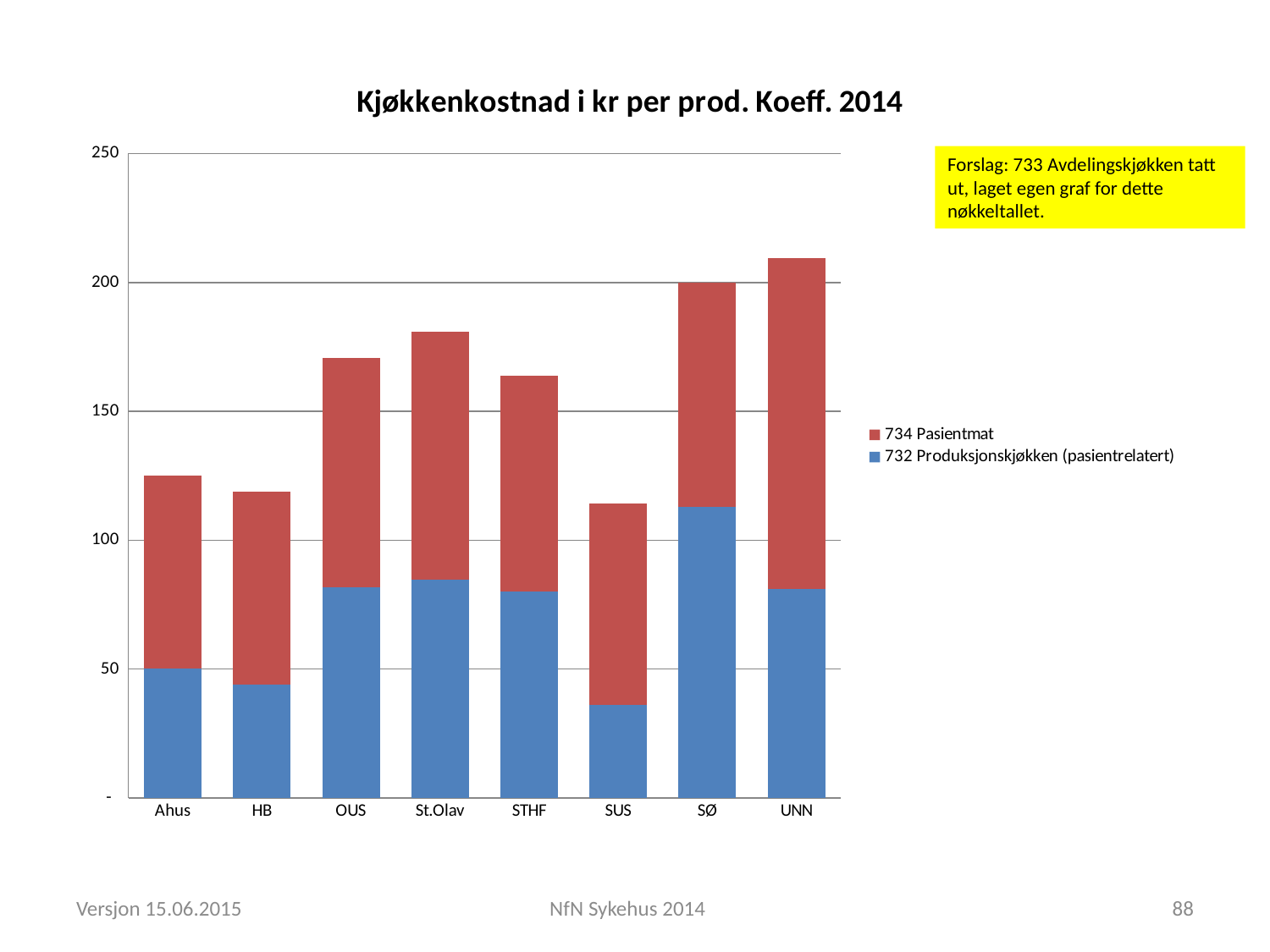
Which hospital has the lowest value for 732 Produksjonskjøkken (pasientrelatert)? SUS How many series does the legend list? 2 Is the total stacked value for OUS greater or less than 150? greater Which hospital has the highest value for 732 Produksjonskjøkken (pasientrelatert)? SØ Which has the larger total stacked bar, OUS or St.Olav? St.Olav What kind of chart is shown on the slide? stacked bar chart Is the value for 732 Produksjonskjøkken (pasientrelatert) for SUS greater or less than 50? less Which colour represents the 734 Pasientmat series? red What is the title of the chart? Kjøkkenkostnad i kr per prod. Koeff. 2014 How many hospitals (categories) are shown on the x axis? 8 Which hospital has the highest total stacked bar? UNN Is the total stacked value for UNN greater or less than 200? greater